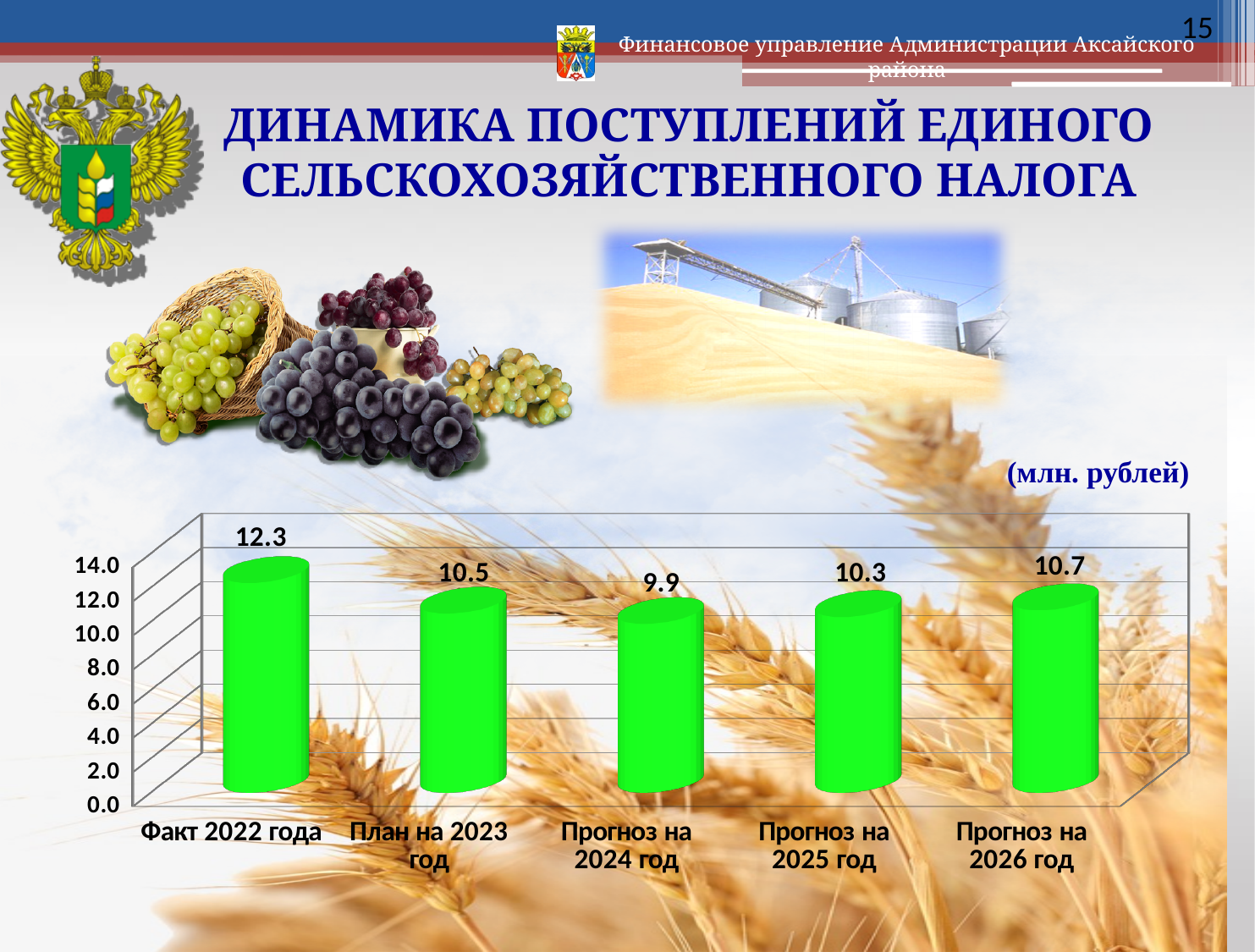
What is the value for Факт 2022 года? 12.3 Which category has the lowest value? Прогноз на 2024 год Which category has the highest value? Факт 2022 года In what units are the values on the chart expressed? млн. рублей Is the value for Прогноз на 2024 год greater or less than 10.0? less What is the value for Прогноз на 2024 год? 9.9 What is the value for План на 2023 год? 10.5 What is the value for Прогноз на 2026 год? 10.7 How many categories are shown on the x axis? 5 What is the difference between the value for Факт 2022 года and the value for План на 2023 год? 1.8 Which is larger, the value for Прогноз на 2025 год or the value for Прогноз на 2026 год? Прогноз на 2026 год What kind of chart is shown on the slide? bar chart